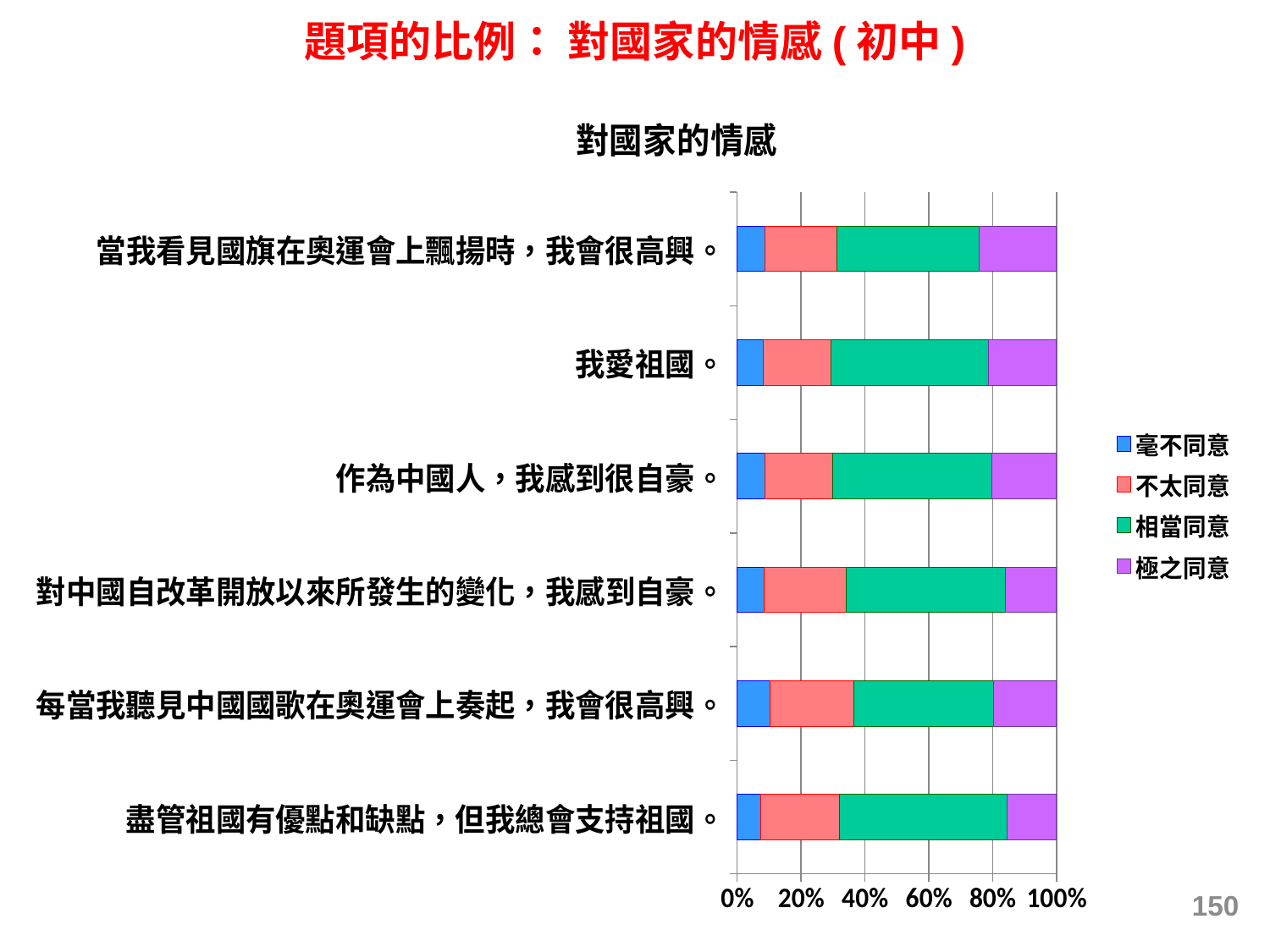
Which response category has the largest share for the statement 我愛祖國。? 相當同意 Is the 極之同意 share for 對中國自改革開放以來所發生的變化，我感到自豪。 greater or less than 20%? less For the statement 每當我聽見中國國歌在奧運會上奏起，我會很高興。, which is larger: the 不太同意 share or the 毫不同意 share? 不太同意 Which legend entry is shown in purple? 極之同意 Is the 毫不同意 share for 當我看見國旗在奧運會上飄揚時，我會很高興。 greater or less than 20%? less How many statements (categories) are plotted in the chart? 6 Is the 相當同意 share for 我愛祖國。 greater or less than 40%? greater Which response category has the smallest share for the statement 盡管祖國有優點和缺點，但我總會支持祖國。? 毫不同意 What is the title of the chart? 對國家的情感 For the statement 作為中國人，我感到很自豪。, which is larger: the 相當同意 share or the 極之同意 share? 相當同意 What kind of chart is shown on the slide? stacked bar chart How many series does the legend list? 4